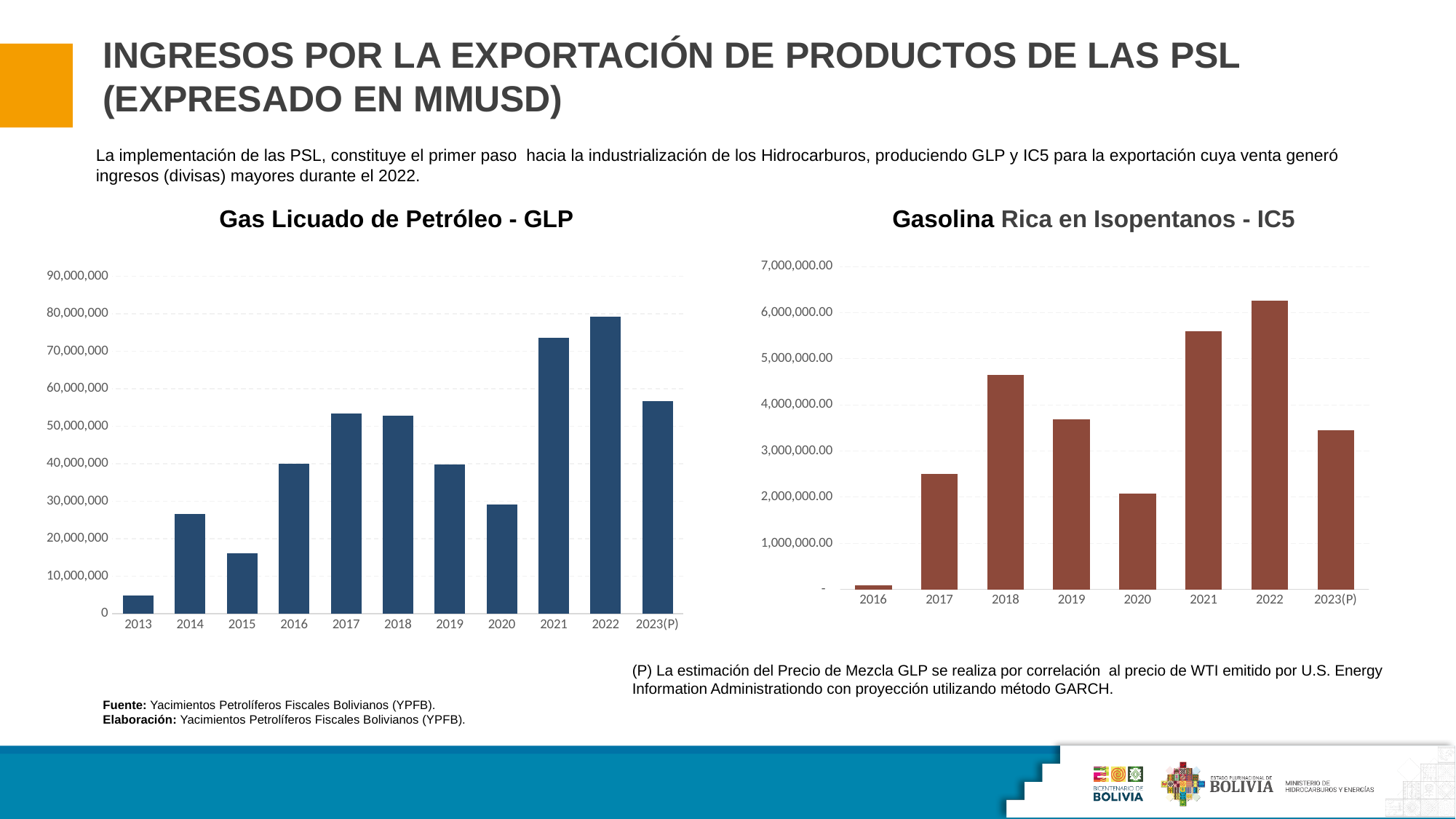
In the 'Gas Licuado de Petróleo - GLP' chart, which is larger, the value for 2020 or the value for 2021? 2021 In the 'Gasolina Rica en Isopentanos - IC5' chart, which is larger, the value for 2017 or the value for 2019? 2019 In the 'Gasolina Rica en Isopentanos - IC5' chart, which year has the highest value? 2022 In the 'Gasolina Rica en Isopentanos - IC5' chart, is the value for 2021 greater or less than 5,000,000.00? greater In the 'Gasolina Rica en Isopentanos - IC5' chart, which year has the lowest value? 2016 In the 'Gas Licuado de Petróleo - GLP' chart, which year has the lowest value? 2013 In the 'Gas Licuado de Petróleo - GLP' chart, which year has the highest value? 2022 In the 'Gas Licuado de Petróleo - GLP' chart, how many years are shown on the x axis? 11 What type of chart is the 'Gasolina Rica en Isopentanos - IC5' chart? Bar chart In the 'Gas Licuado de Petróleo - GLP' chart, is the value for 2021 greater or less than 70,000,000? greater In the 'Gasolina Rica en Isopentanos - IC5' chart, how many years are shown on the x axis? 8 In the 'Gas Licuado de Petróleo - GLP' chart, is the value for 2015 greater or less than 20,000,000? less